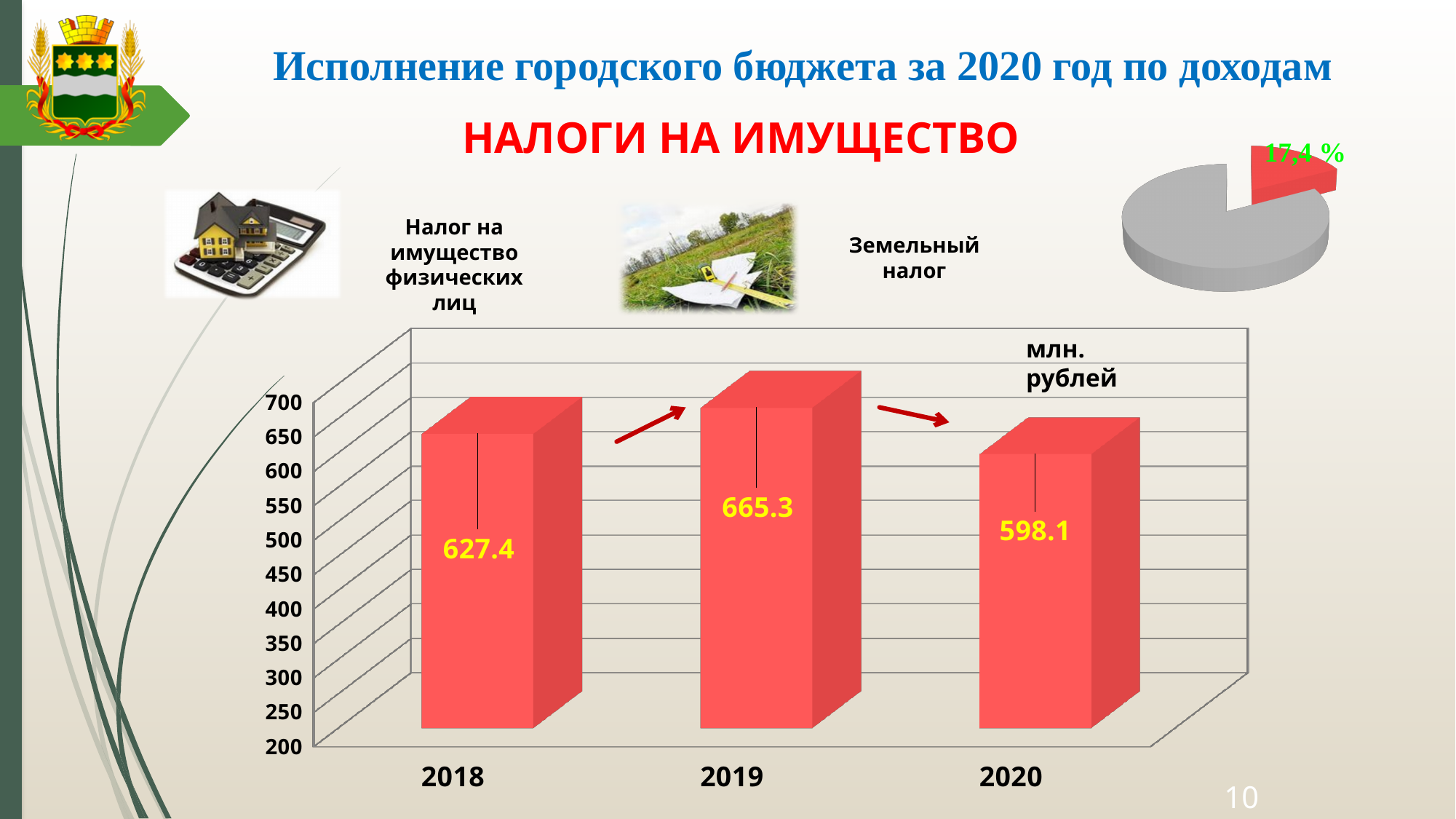
What type of chart shows the values for 2018, 2019 and 2020? bar chart On the bar chart, what is the value for 2019? 665.3 On the bar chart, is the value for 2020 greater or less than 600? less On the pie chart in the top right, what percentage is shown for the highlighted red slice? 17,4 % On the bar chart, what is the difference between the 2019 and 2020 values? 67.2 On the bar chart, which is larger, the value for 2018 or the value for 2020? 2018 On the bar chart, what is the difference between the 2019 and 2018 values? 37.9 On the bar chart, what is the value for 2018? 627.4 On the bar chart, which year has the lowest value? 2020 How many bars are shown on the bar chart? 3 On the bar chart, which year has the highest value? 2019 On the bar chart, what is the value for 2020? 598.1